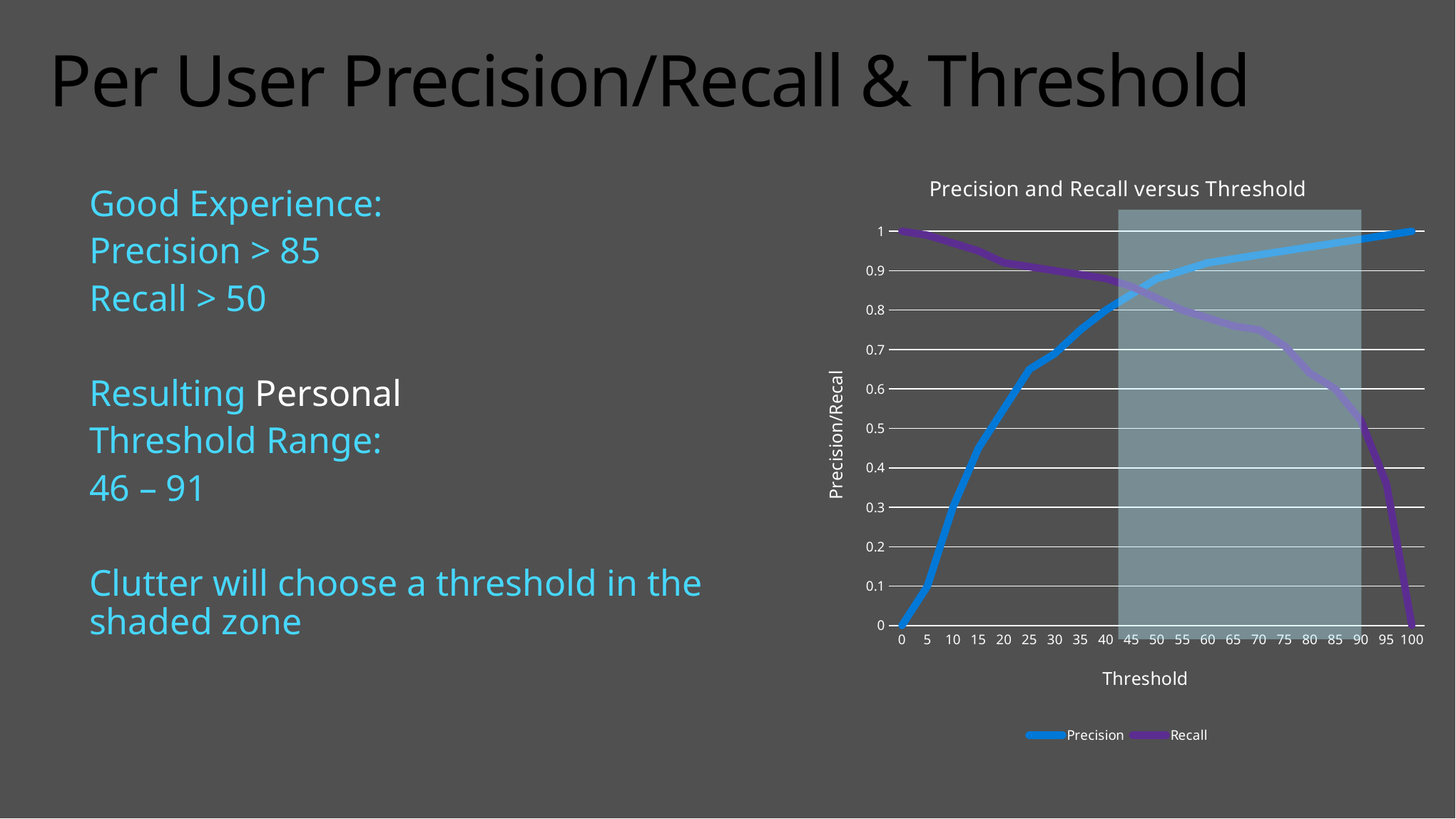
What is the value of Precision at threshold 0? 0 What is the value of Recall at threshold 100? 0 What kind of chart is shown on the slide? line chart How many series does the chart legend list? 2 Is the value of Precision at threshold 25 greater or less than 0.5? greater Is the value of Recall at threshold 50 greater or less than 0.8? greater Does the Precision series rise or fall as the threshold increases along the x axis? rise What is the value of Recall at threshold 0? 1 Does the Recall series rise or fall as the threshold increases along the x axis? fall What is the label of the y axis of the chart? Precision/Recall What is the title of the chart? Precision and Recall versus Threshold At threshold 75, which series has the larger value, Precision or Recall? Precision